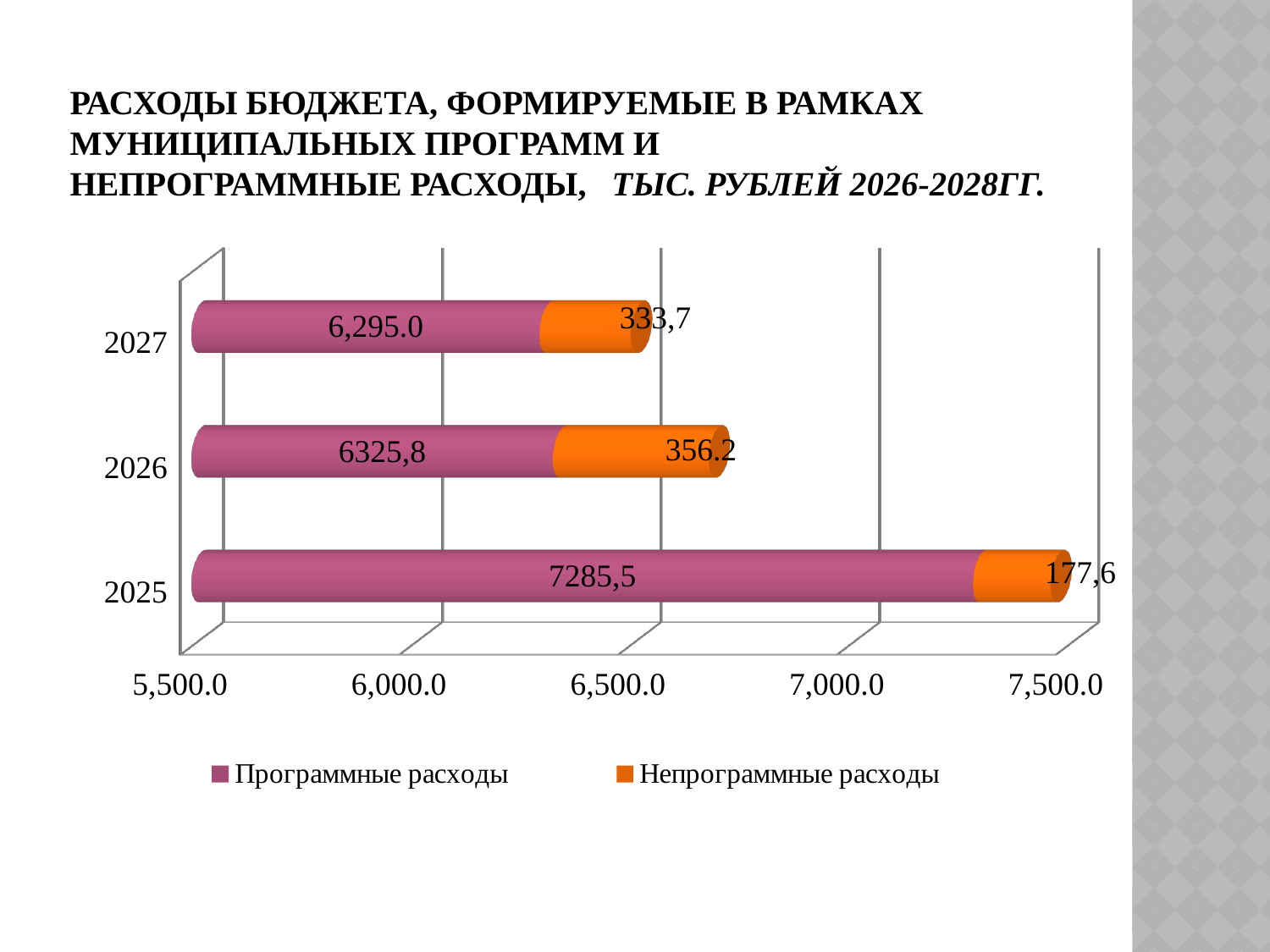
What is the difference between Непрограммные расходы in 2026 and 2027? 22.5 Which year has the larger value of Программные расходы, 2026 or 2027? 2026 How many years are shown on the chart? 3 What kind of chart is shown on the slide? bar chart Which year has the lowest value of Непрограммные расходы? 2025 What is the value of Программные расходы for 2027? 6,295.0 Which year has the highest value of Программные расходы? 2025 Is the value of Программные расходы for 2025 greater or less than 7,000.0? greater How many series does the legend list? 2 What is the value of Программные расходы for 2025? 7285,5 What is the value of Непрограммные расходы for 2026? 356.2 What is the value of Непрограммные расходы for 2025? 177,6